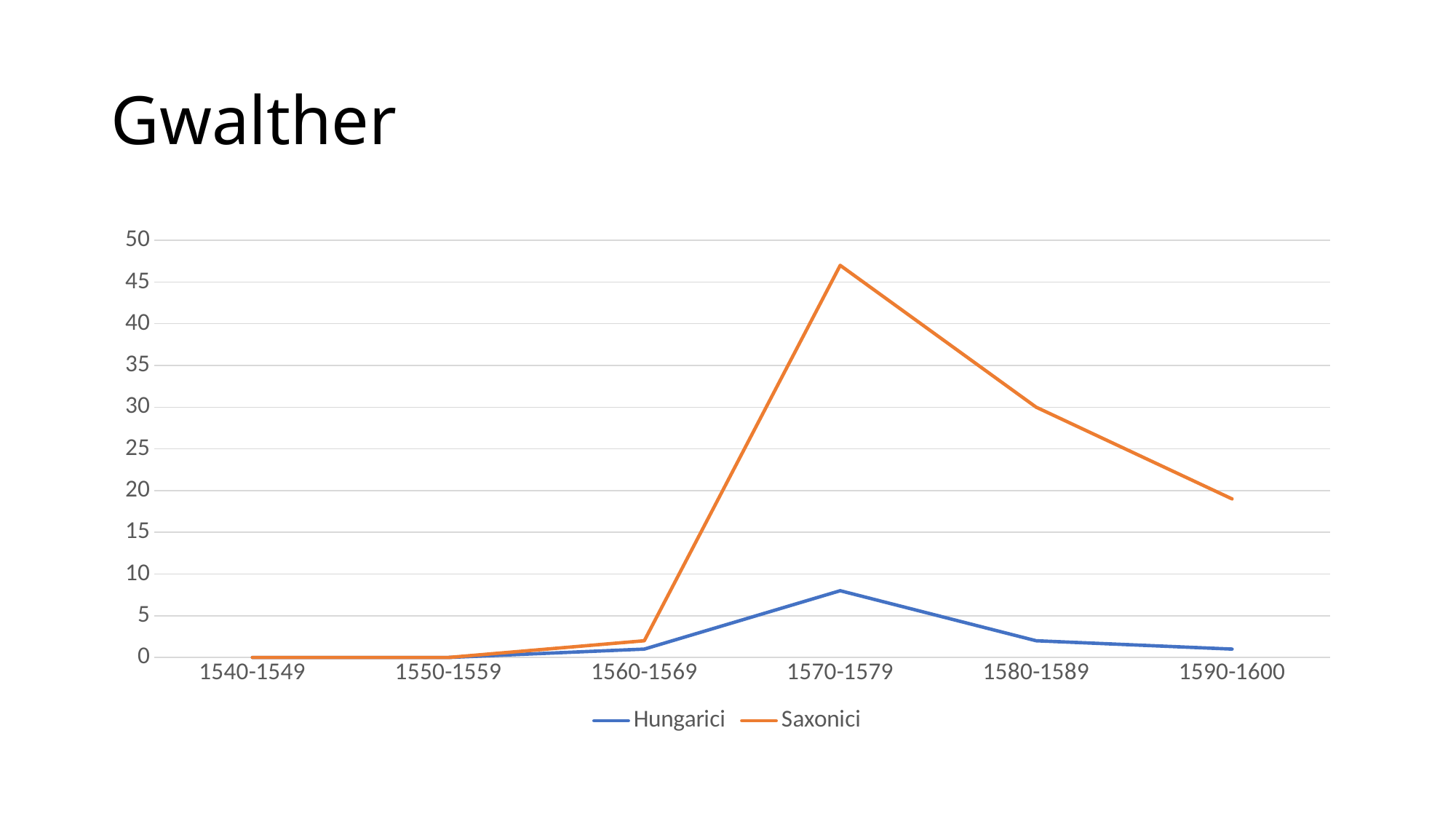
Is the value for Hungarici in 1570-1579 greater or less than 10? less How many series does the legend list? 2 What kind of chart is shown on the slide? line chart How many periods are shown along the x axis? 6 In which period does the Hungarici series reach its highest value? 1570-1579 Does the Saxonici series rise or fall from 1570-1579 to 1590-1600? fall Is the value for Saxonici in 1590-1600 greater or less than 20? less In which period does the Saxonici series reach its highest value? 1570-1579 Which series has the larger value in 1580-1589, Hungarici or Saxonici? Saxonici What is the value of the Hungarici series for 1540-1549? 0